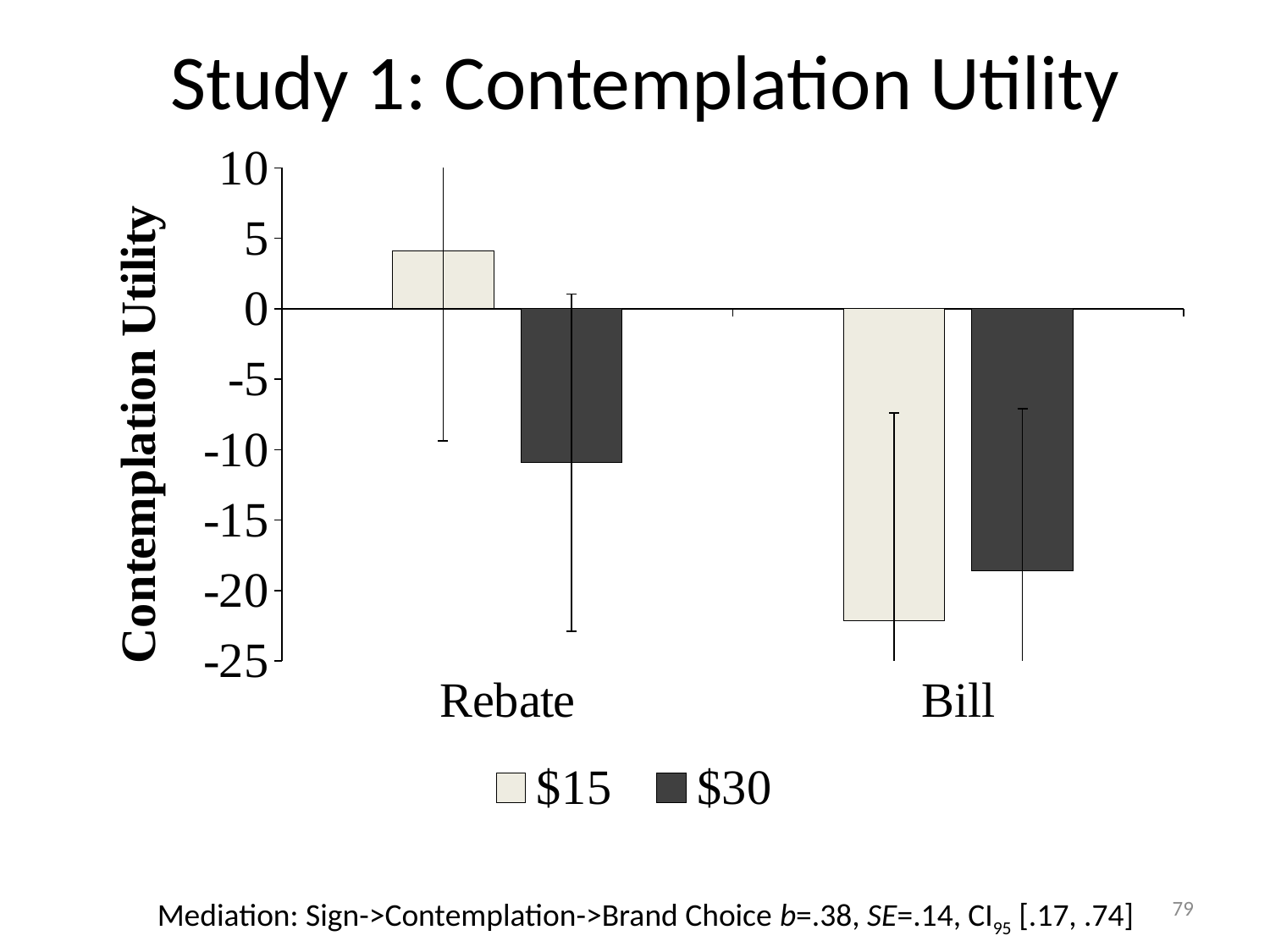
Which category and series combination has the lowest contemplation utility? Bill, $15 Is the value for $15 in the Rebate condition greater or less than 0? greater Is the value for $30 in the Rebate condition greater or less than -5? less In the Bill condition, which series has the larger value, $15 or $30? $30 How many categories are shown on the x axis? 2 Which category and series combination has the highest contemplation utility? Rebate, $15 In the Rebate condition, which series has the larger value, $15 or $30? $15 What kind of chart is shown on the slide? bar chart How many series does the legend list? 2 Is the value for $15 in the Bill condition greater or less than -20? less What is the label on the vertical axis? Contemplation Utility